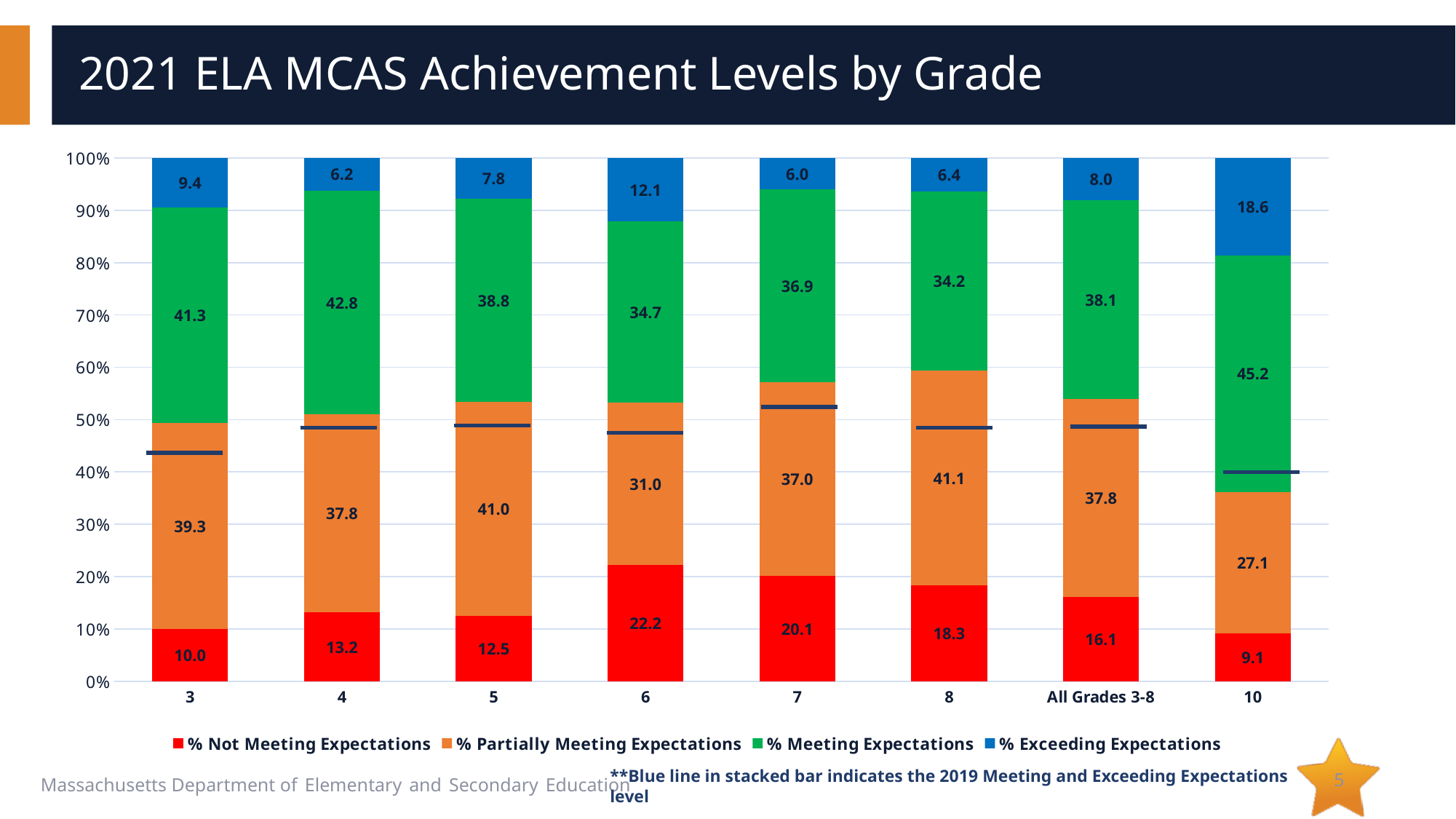
Which grade has the highest % Exceeding Expectations? 10 Which has a larger % Not Meeting Expectations, grade 7 or grade 8? Grade 7 What is the % Exceeding Expectations value for grade 10? 18.6 How many series does the legend list? 4 What is the % Meeting Expectations value for All Grades 3-8? 38.1 What kind of chart is shown on the slide? Stacked bar chart Which grade has the highest % Not Meeting Expectations? 6 Which grade has the lowest % Not Meeting Expectations? 10 What is the % Not Meeting Expectations value for grade 6? 22.2 What is the difference between the % Meeting Expectations for grade 4 and grade 3? 1.5 How many grade categories are shown on the x axis? 8 What is the combined % Meeting and Exceeding Expectations for grade 10? 63.8